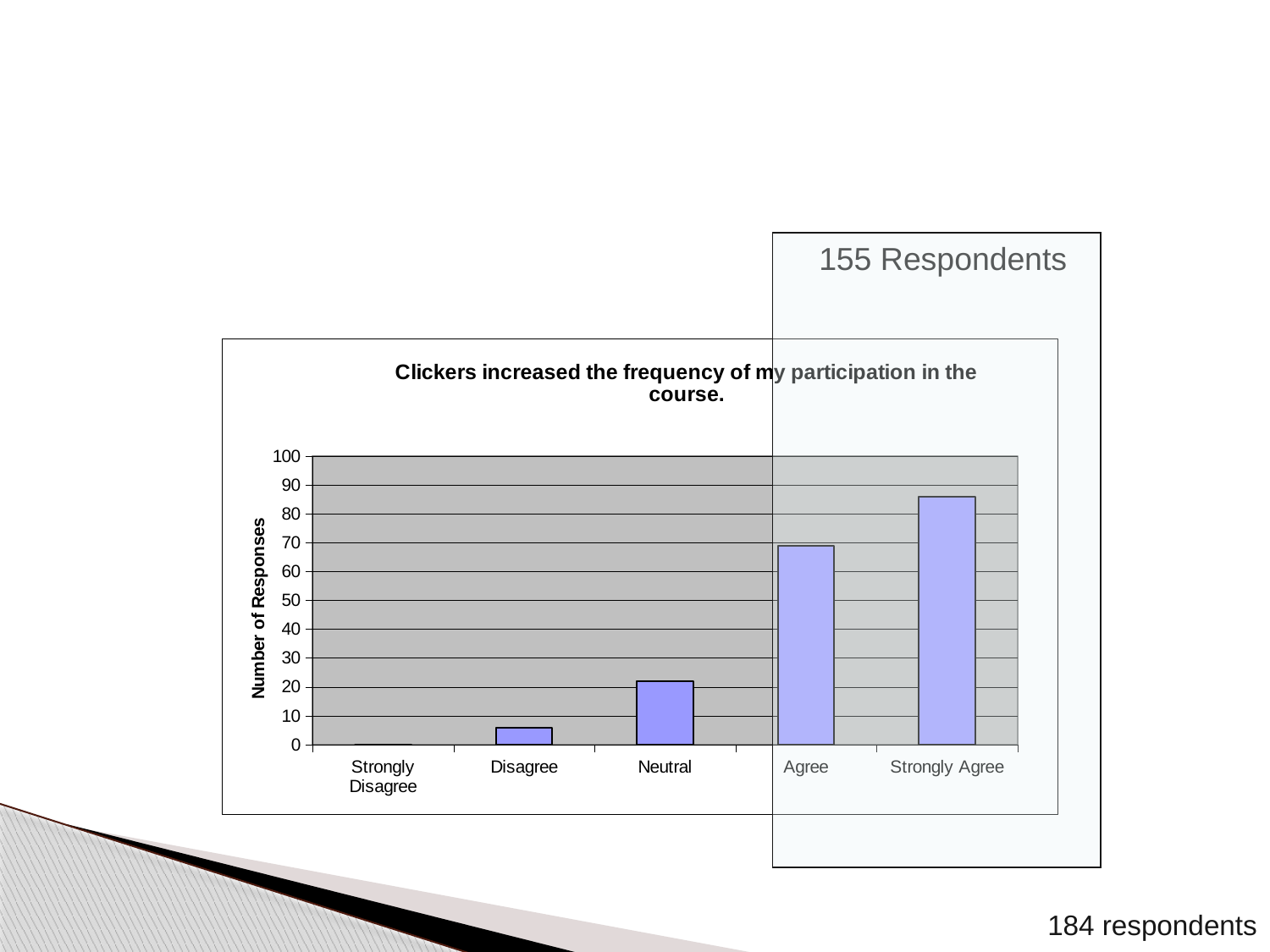
Which has more responses, Disagree or Neutral? Neutral Which has more responses, Agree or Neutral? Agree Is the value for Strongly Agree greater or less than 80? greater Is the value for Disagree greater or less than 10? less What kind of chart is shown on the slide? bar chart How many response categories are shown on the x axis of the chart? 5 Which response category has the highest number of responses? Strongly Agree What is the label on the vertical axis of the chart? Number of Responses Which response category has the lowest number of responses? Strongly Disagree Do the values rise or fall moving from Strongly Disagree to Strongly Agree along the x axis? rise Is the value for Agree greater or less than 60? greater